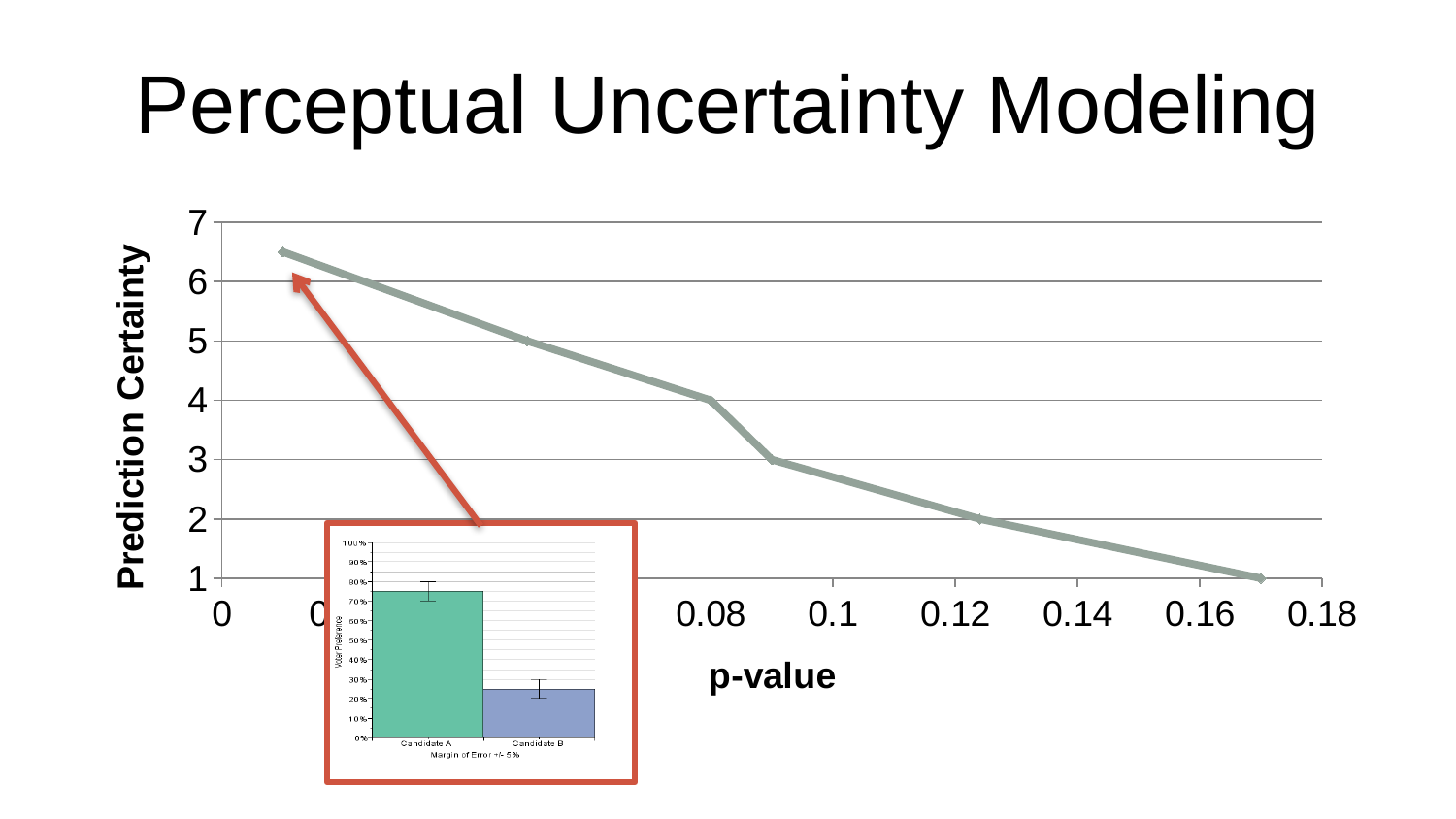
What is the title of the vertical axis on the large line chart? Prediction Certainty In the small inset bar chart, which candidate has the taller bar, Candidate A or Candidate B? Candidate A In the large line chart, is the Prediction Certainty of the point at a p-value of about 0.09 greater or less than 4? less In the large line chart, what is the Prediction Certainty at a p-value of 0.08? 4 In the large line chart, does Prediction Certainty rise or fall as the p-value increases? fall How many categories are shown in the small inset bar chart? 2 What kind of chart is the small inset chart in the red box? bar chart In the small inset bar chart, is the value for Candidate B greater or less than 50%? less In the large line chart, is the Prediction Certainty of the first (leftmost) point greater or less than 6? greater How many data points are plotted on the large line chart? 6 What kind of chart is the large chart plotting Prediction Certainty against p-value? line chart In the large line chart, what is the lowest Prediction Certainty value plotted? 1